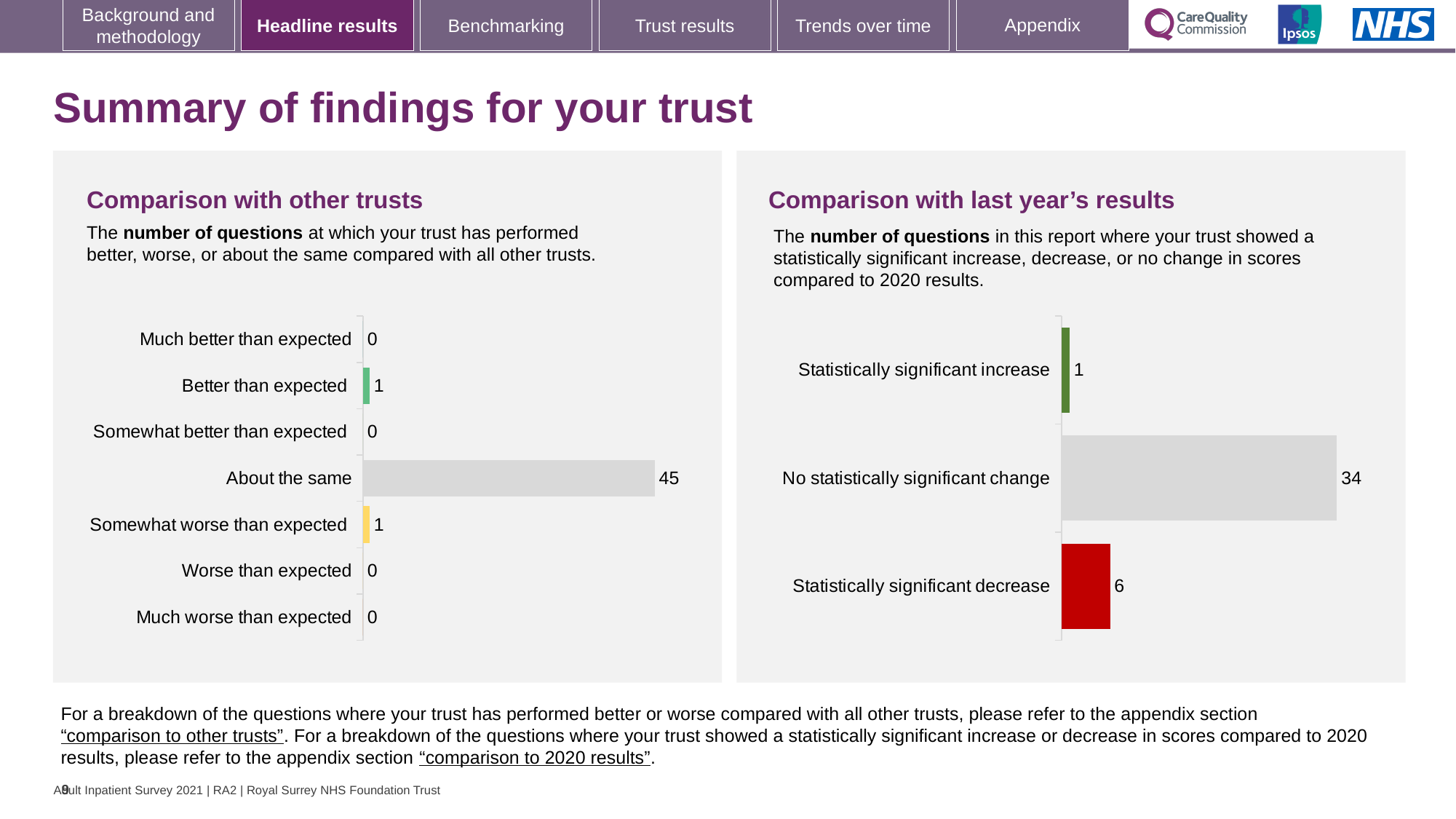
In the 'Comparison with other trusts' chart, how many categories are shown? 7 In the 'Comparison with last year's results' chart, what is the total number of questions across all three categories? 41 In the 'Comparison with other trusts' chart, how many questions are 'About the same'? 45 In the 'Comparison with last year's results' chart, how many questions showed no statistically significant change? 34 In the 'Comparison with other trusts' chart, what is the difference between 'About the same' and 'Better than expected'? 44 In the 'Comparison with last year's results' chart, is the value for 'Statistically significant decrease' larger or smaller than the value for 'Statistically significant increase'? larger In the 'Comparison with other trusts' chart, which category has the highest number of questions? About the same What type of chart is used in the 'Comparison with last year's results' panel? Bar chart In the 'Comparison with last year's results' chart, how many questions showed a statistically significant decrease? 6 In the 'Comparison with last year's results' chart, which category has the lowest value? Statistically significant increase In the 'Comparison with other trusts' chart, how many questions are 'Somewhat worse than expected'? 1 In the 'Comparison with other trusts' chart, how many questions are 'Better than expected'? 1